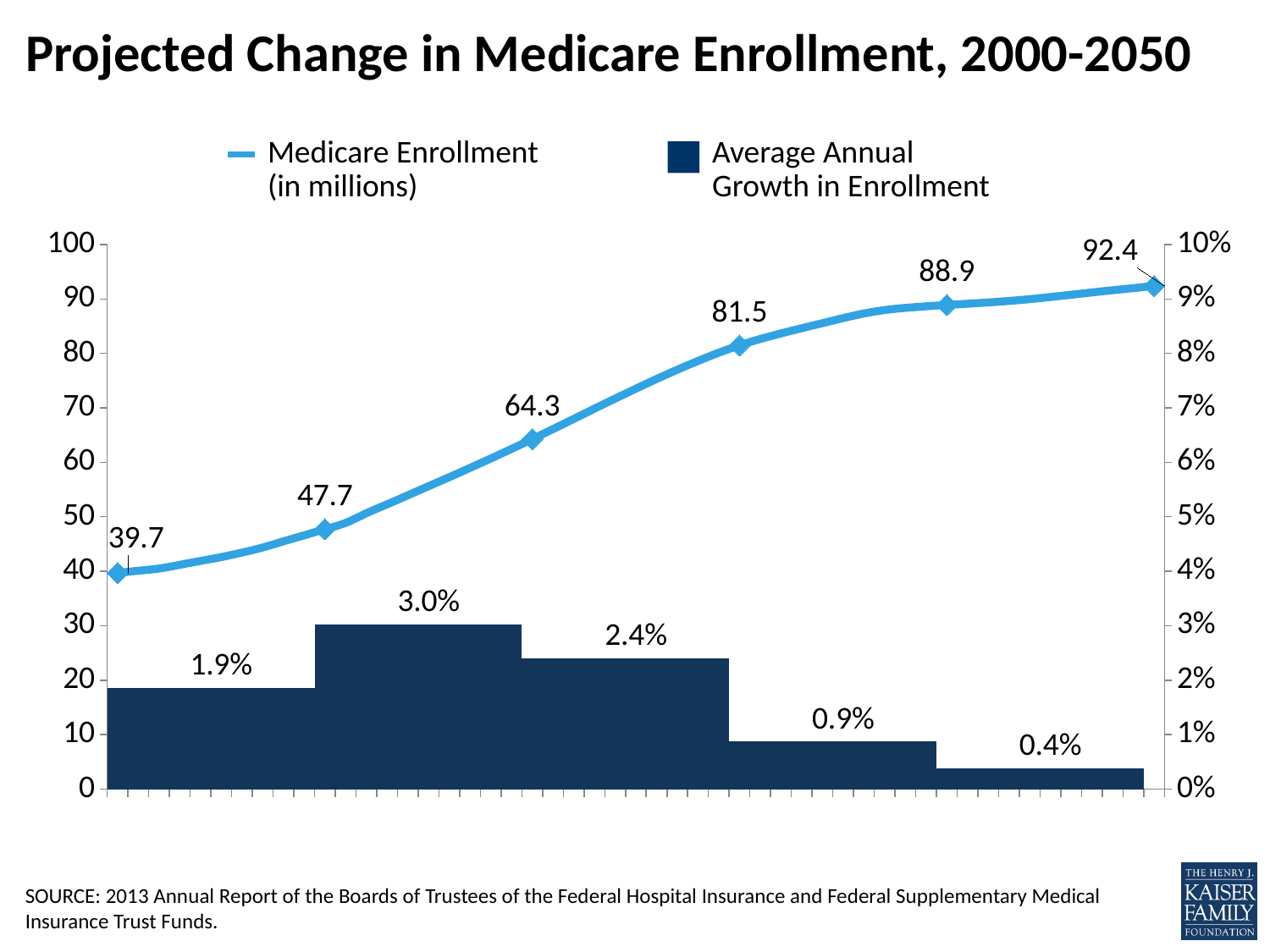
What is the title of the chart? Projected Change in Medicare Enrollment, 2000-2050 What is the lowest Medicare Enrollment value shown on the line? 39.7 What is the highest Medicare Enrollment value shown on the line? 92.4 Does the Medicare Enrollment line rise or fall from left to right? rise What is the difference between the highest and lowest Medicare Enrollment values on the line? 52.7 Which is larger: the third Average Annual Growth bar (2.4%) or the fourth bar (0.9%)? 2.4% How many data points are plotted on the Medicare Enrollment line? 6 How many series does the legend list? 2 What is the difference between the first bar (1.9%) and the second bar (3.0%) for Average Annual Growth in Enrollment? 1.1% How many bars are shown for Average Annual Growth in Enrollment? 5 What is the lowest Average Annual Growth in Enrollment value shown by the bars? 0.4% What is the highest Average Annual Growth in Enrollment value shown by the bars? 3.0%